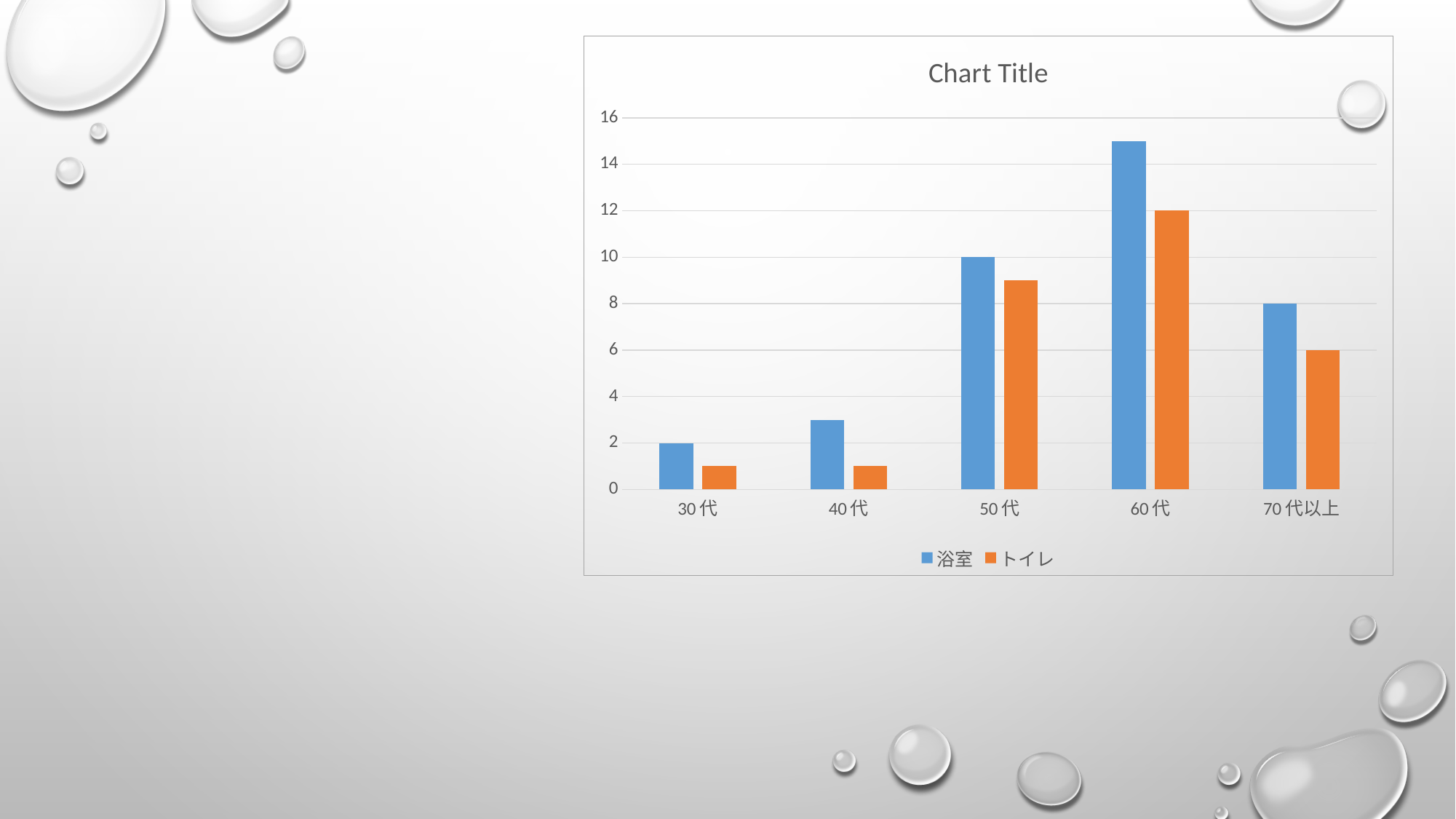
What type of chart is shown on the slide? Bar chart In the 60代 category, which series has the larger value, 浴室 or トイレ? 浴室 What is the title of the chart? Chart Title What is the value for 浴室 in the 70代以上 category? 8 How many age categories are shown on the x axis? 5 What is the value for 浴室 in the 50代 category? 10 What is the difference between the 浴室 and トイレ values in the 70代以上 category? 2 Is the value for 浴室 in the 60代 category greater or less than 14? greater Which age category has the highest value for 浴室? 60代 Which age category has the lowest value for 浴室? 30代 How many series does the legend list? 2 What is the value for トイレ in the 60代 category? 12